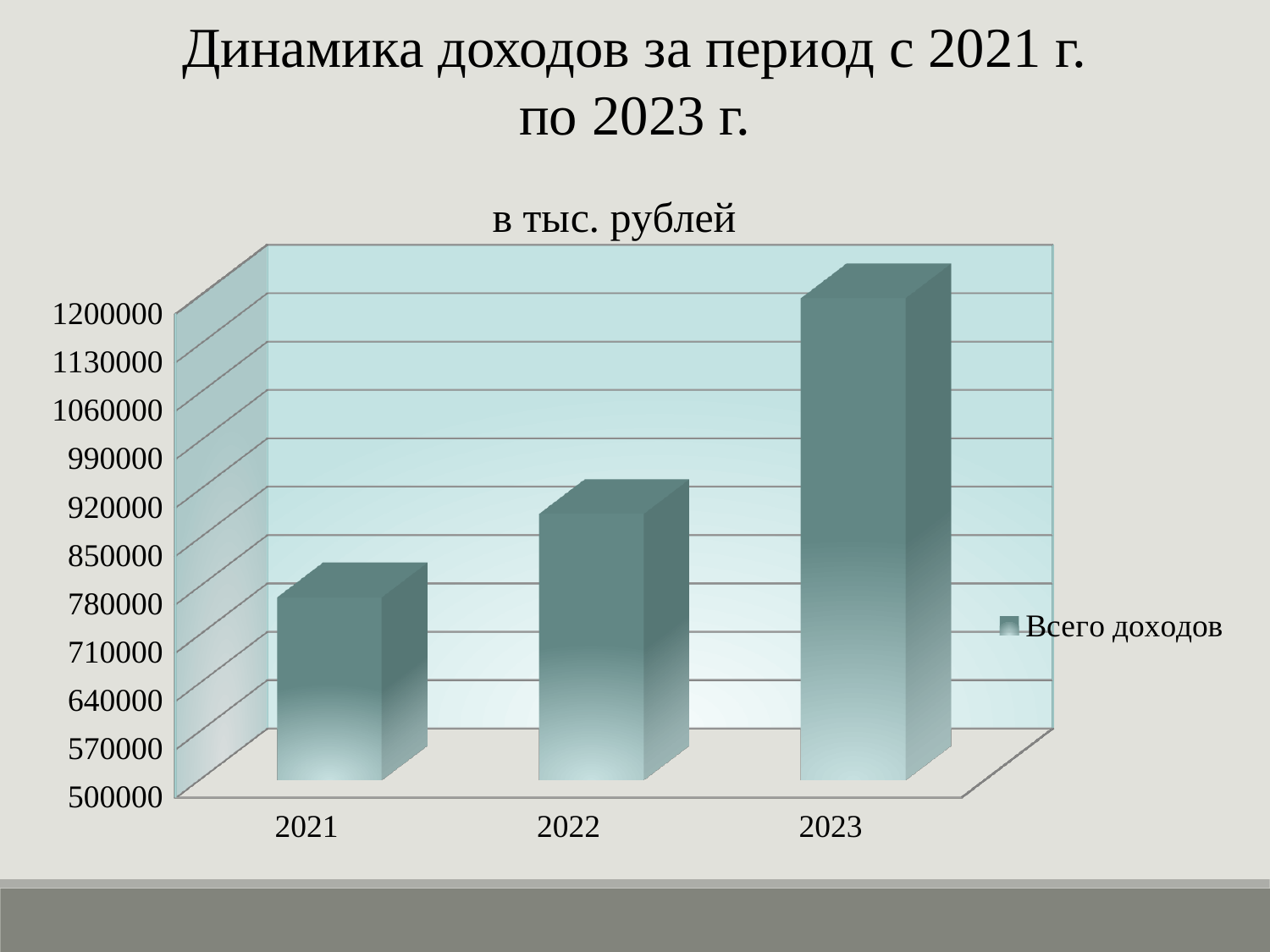
What unit is stated in the chart's title above the plot area? в тыс. рублей Which is larger, the value for 2022 or the value for 2021? 2022 How many series does the legend list? 1 Is the value for 2022 greater or less than 850000? greater Which year has the highest value for Всего доходов? 2023 What is the name of the series shown in the legend? Всего доходов How many years (categories) are plotted on the chart? 3 What kind of chart is shown on the slide? bar chart Which year has the lowest value for Всего доходов? 2021 Is the value for 2023 greater or less than 1060000? greater Do the values rise or fall from 2021 to 2023? rise Is the value for 2021 greater or less than 850000? less